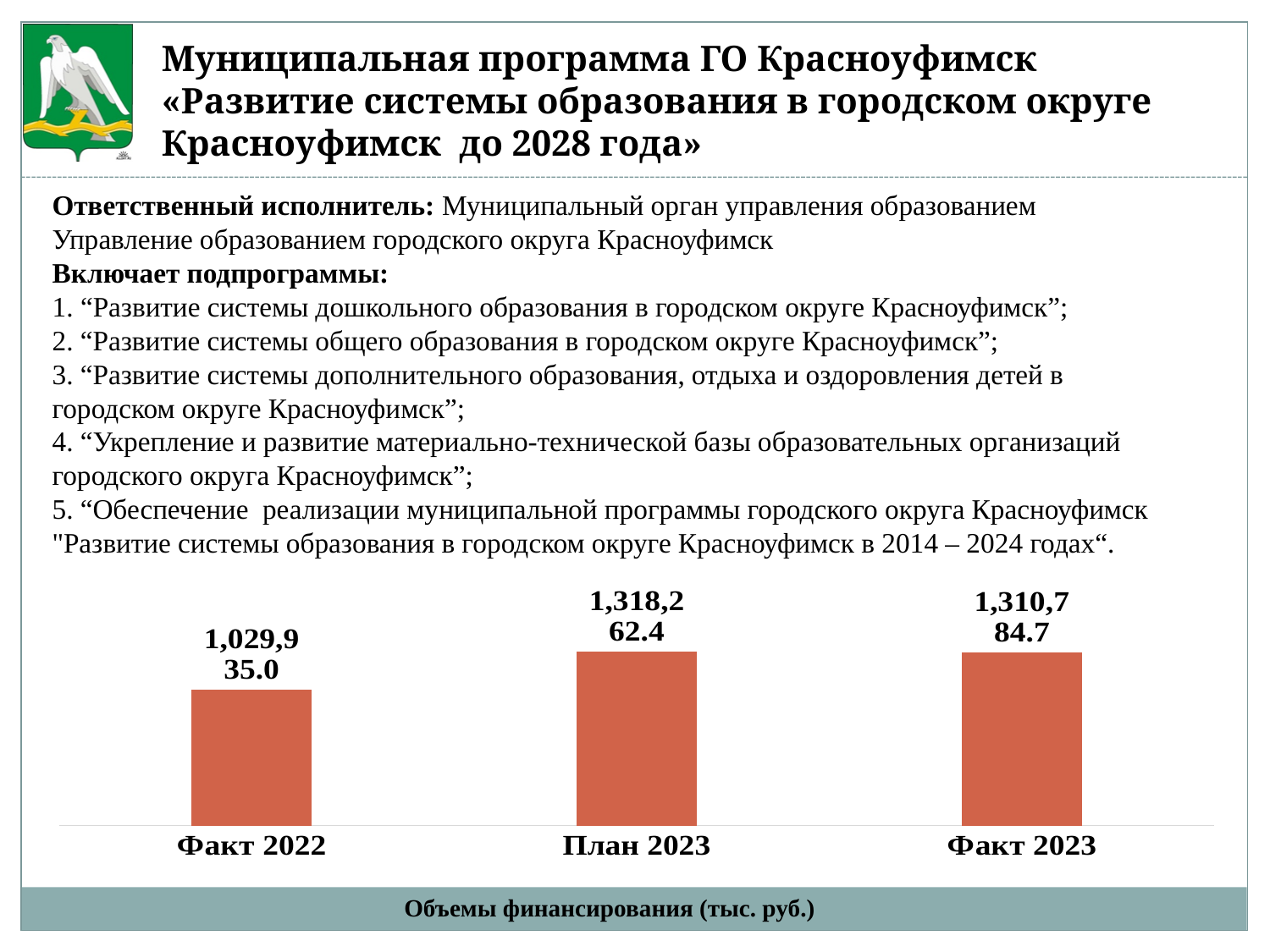
What colour are the bars in the chart? orange-red Which category has the lowest value? Факт 2022 What is the difference between the values for План 2023 and Факт 2023? 7,477.7 What is the difference between the values for План 2023 and Факт 2022? 288,327.4 What is the value shown for Факт 2022? 1,029,935.0 What kind of chart is shown on the slide? bar chart What is the caption shown below the chart? Объемы финансирования (тыс. руб.) What is the value shown for Факт 2023? 1,310,784.7 Which is larger, the value for Факт 2022 or the value for Факт 2023? Факт 2023 How many bars does the chart show? 3 Which category has the highest value? План 2023 What is the value shown for План 2023? 1,318,262.4